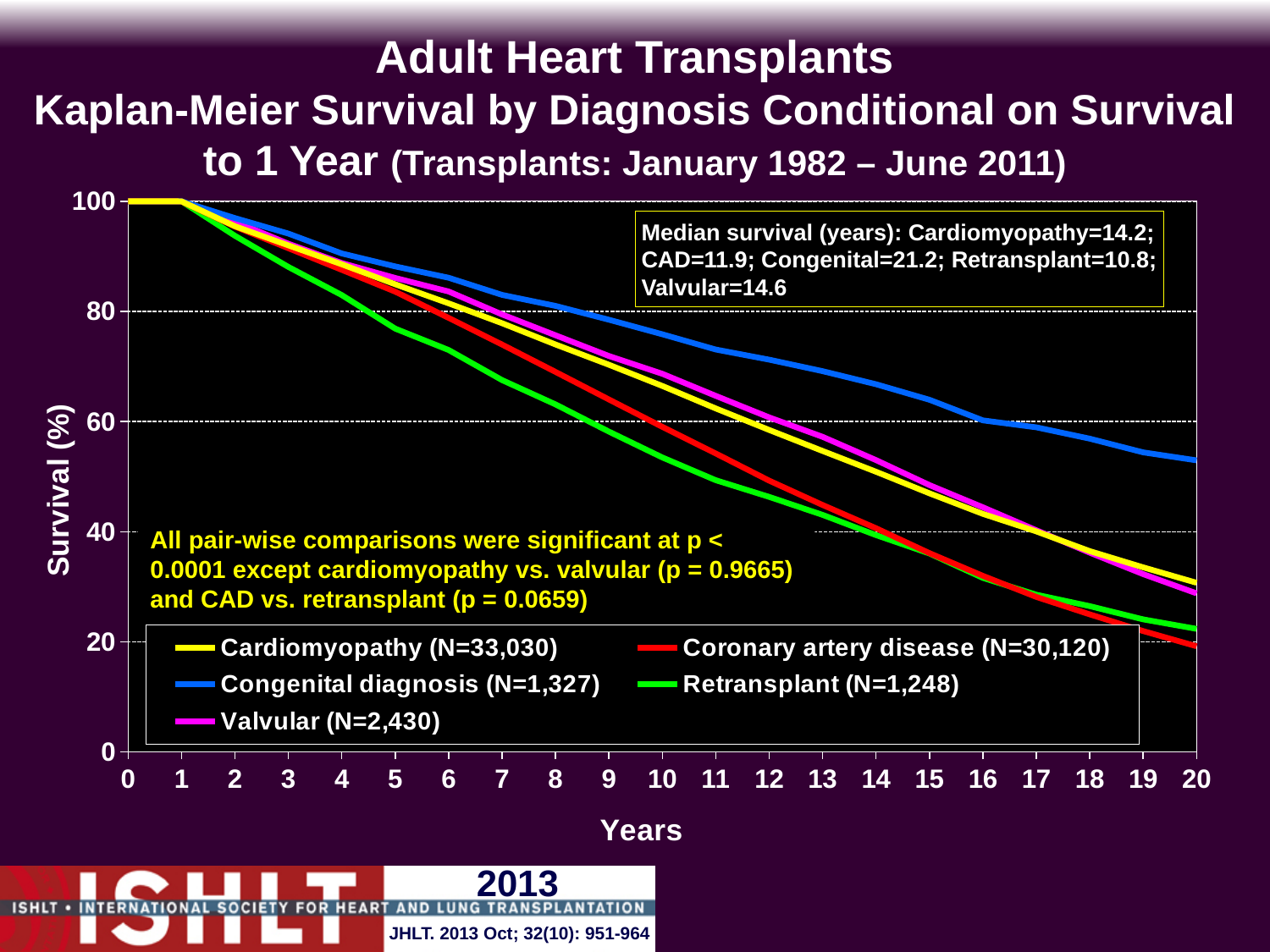
Do the survival curves rise or fall as years increase along the x axis? fall What is the difference in median survival (years) between Cardiomyopathy (14.2) and CAD (11.9)? 2.3 How many diagnosis groups (series) does the legend list? 5 Which diagnosis group has the highest median survival listed in the text box? Congenital What colour is the line for the Valvular group in the legend? magenta (pink) What kind of chart is shown on the slide? line chart Which diagnosis group has the lowest median survival listed in the text box? Retransplant What is the N for the Cardiomyopathy group shown in the legend? 33,030 Is the survival value for the Congenital diagnosis curve at 10 years greater or less than 60? greater According to the text box, what is the median survival in years for the Congenital group? 21.2 At 20 years, which curve shows higher survival: Congenital diagnosis or Coronary artery disease? Congenital diagnosis Is the survival value for the Retransplant curve at 20 years greater or less than 40? less